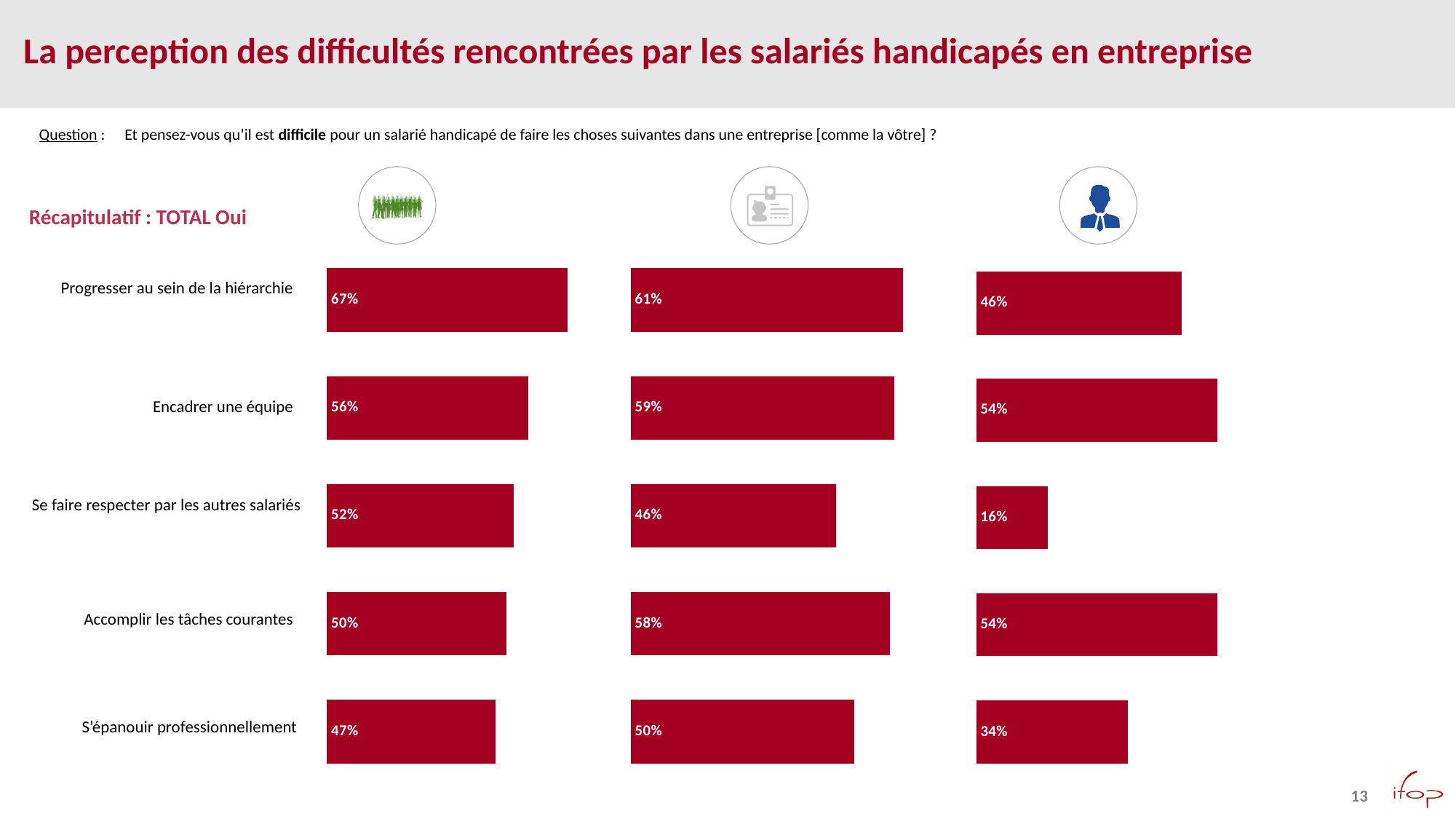
In the right chart, what is the value for "S'épanouir professionnellement"? 34% In the left chart, what is the difference between the values for "Progresser au sein de la hiérarchie" and "S'épanouir professionnellement"? 20% What kind of chart is the middle chart? Bar chart In the left chart, what is the value for "Progresser au sein de la hiérarchie"? 67% How many categories does the left chart show? 5 In the left chart, which category has the highest value? Progresser au sein de la hiérarchie In the middle chart, what is the value for "Accomplir les tâches courantes"? 58% In the middle chart, which is larger: the value for "Progresser au sein de la hiérarchie" or the value for "S'épanouir professionnellement"? Progresser au sein de la hiérarchie In the right chart, which category has the lowest value? Se faire respecter par les autres salariés In the middle chart, which category has the lowest value? Se faire respecter par les autres salariés In the right chart, what is the difference between the values for "Encadrer une équipe" and "Se faire respecter par les autres salariés"? 38% In the right chart, what is the value for "Se faire respecter par les autres salariés"? 16%